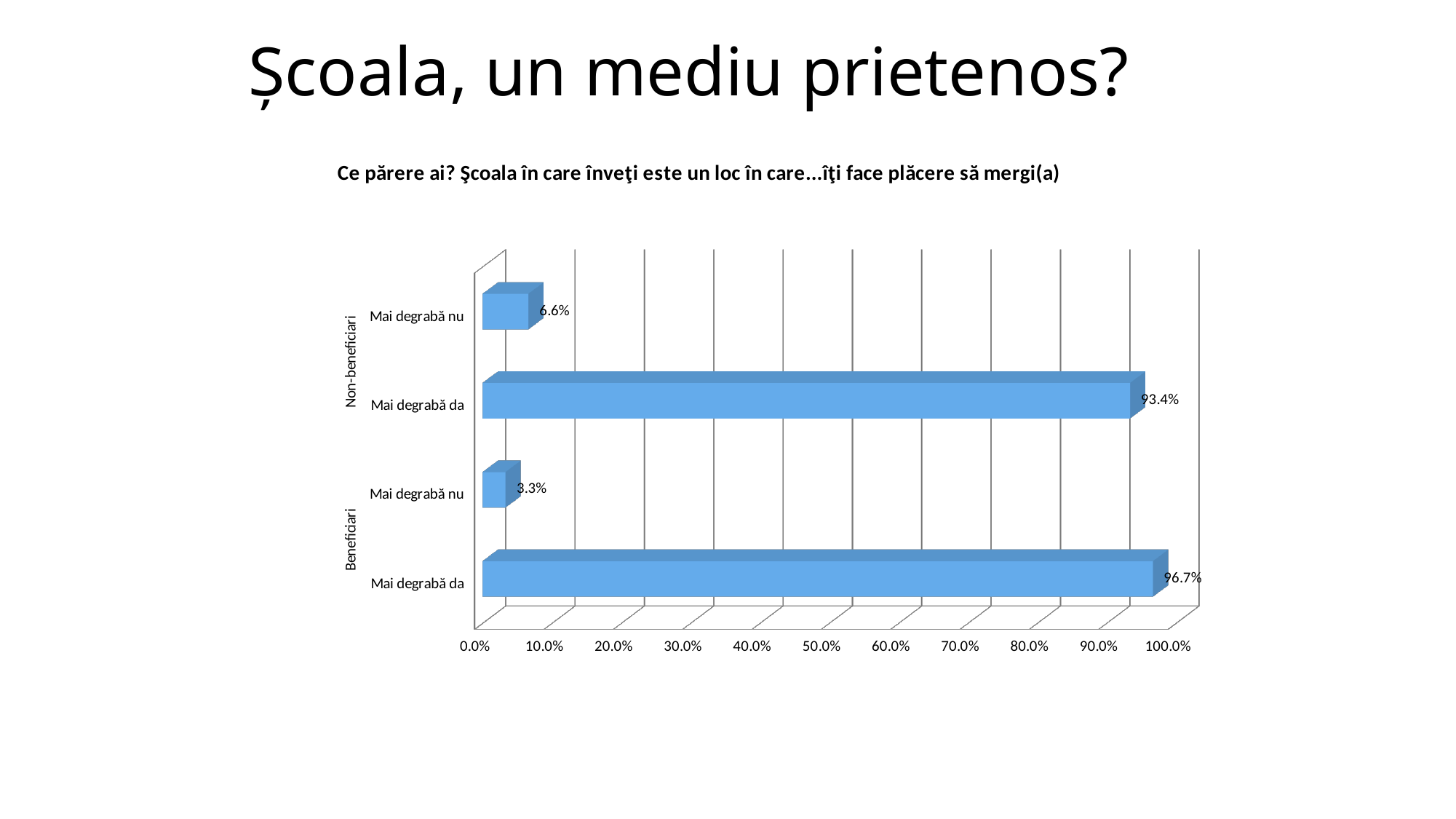
What is the difference between "Mai degrabă da" for Beneficiari and "Mai degrabă da" for Non-beneficiari? 3.3% What is the value for "Mai degrabă da" in the Non-beneficiari group? 93.4% What is the value for "Mai degrabă nu" in the Non-beneficiari group? 6.6% What is the value for "Mai degrabă da" in the Beneficiari group? 96.7% What is the value for "Mai degrabă nu" in the Beneficiari group? 3.3% Which bar has the highest value? Mai degrabă da (Beneficiari) Is the value for "Mai degrabă da" in the Non-beneficiari group greater or less than 90.0%? greater How many bars are plotted on the chart? 4 Which bar has the lowest value? Mai degrabă nu (Beneficiari) Which is larger: "Mai degrabă nu" for Beneficiari or "Mai degrabă nu" for Non-beneficiari? Non-beneficiari What kind of chart is shown on the slide? Bar chart What is the title of the chart? Ce părere ai? Şcoala în care înveţi este un loc în care...îţi face plăcere să mergi(a)